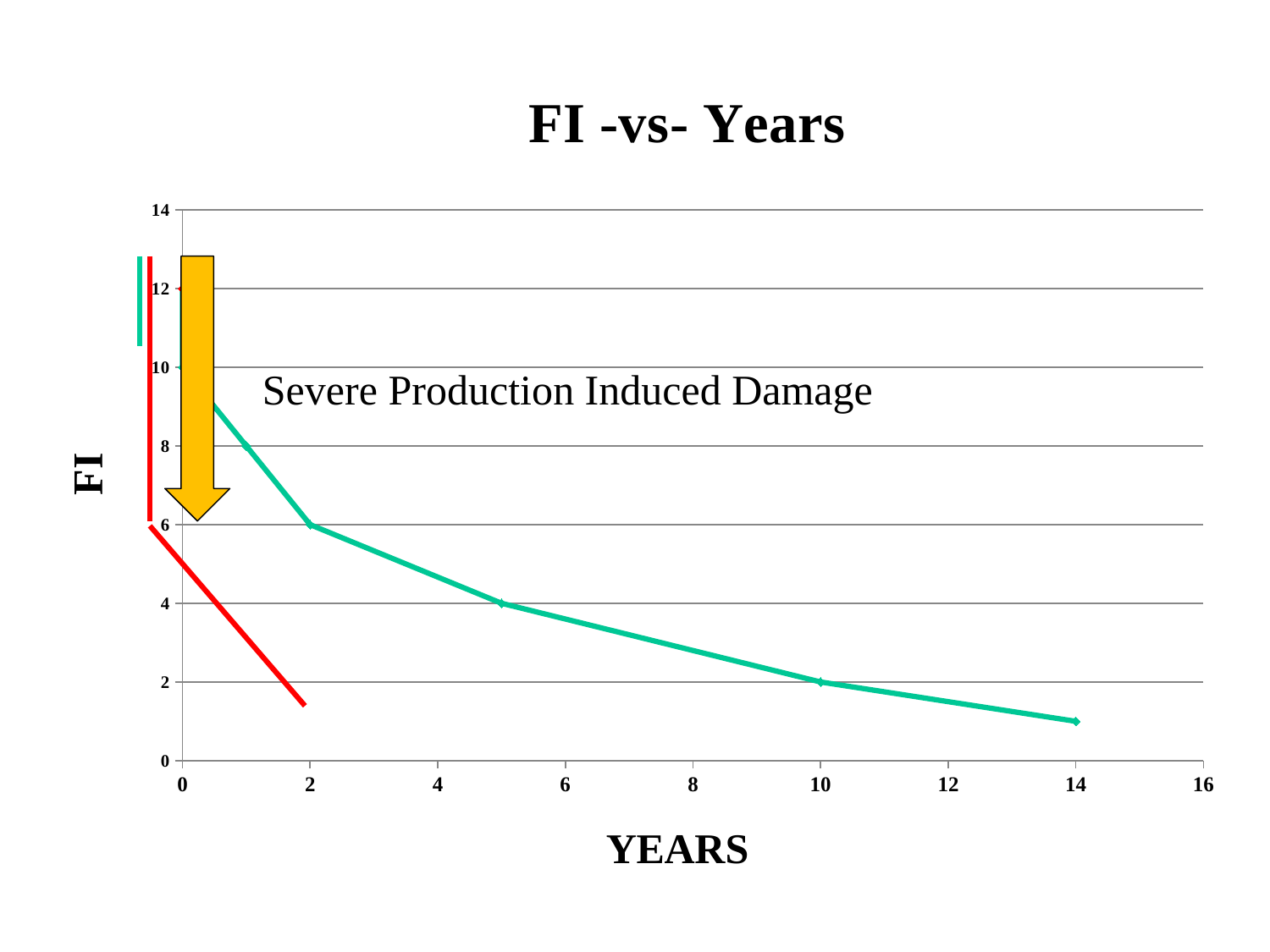
At year 2, which line has the higher FI value, the green line or the red line? green line What is the FI value of the green line at year 2? 6 Is the FI value of the green line at year 14 greater or less than 2? less Is the FI value of the green line at year 10 greater or less than 4? less What type of chart is shown on the slide? line chart What is the label of the x axis? YEARS Does the FI value of the green line rise or fall as the years increase? fall What is the title of the chart? FI -vs- Years Is the FI value of the red line at year 2 greater or less than 2? less Does the FI value of the red line rise or fall as the years increase? fall What is the FI value of the green line at year 10? 2